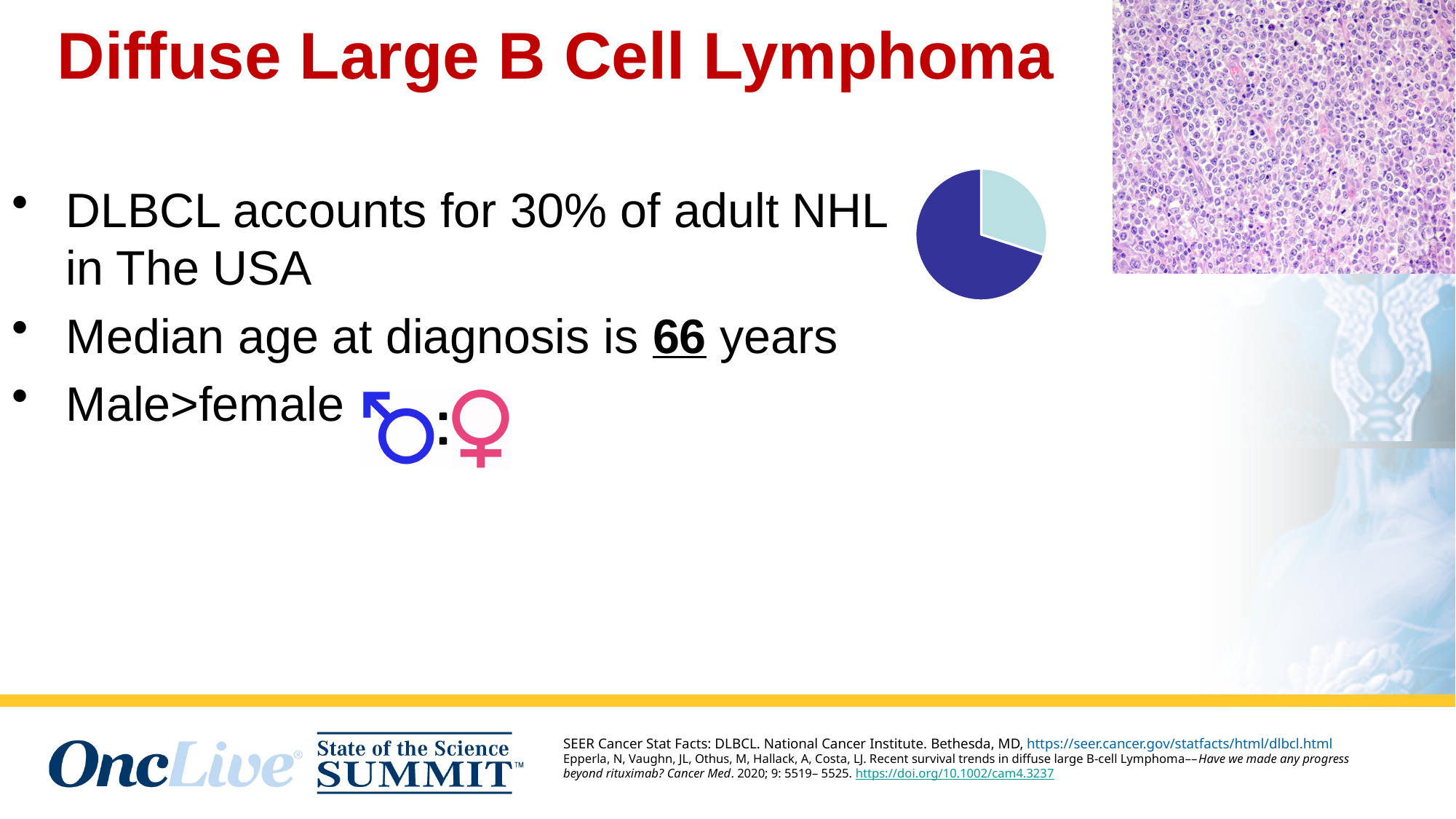
Which slice of the pie chart is larger, the dark blue one or the light blue one? dark blue What kind of chart is shown on the slide? pie chart Does the pie chart have a legend? No Is the light blue slice of the pie chart greater or less than half of the pie? less Which slice of the pie chart is smaller, the dark blue one or the light blue one? light blue How many slices does the pie chart have? 2 According to the slide, what share of adult NHL in the USA does the light blue slice of the pie chart represent (DLBCL)? 30%